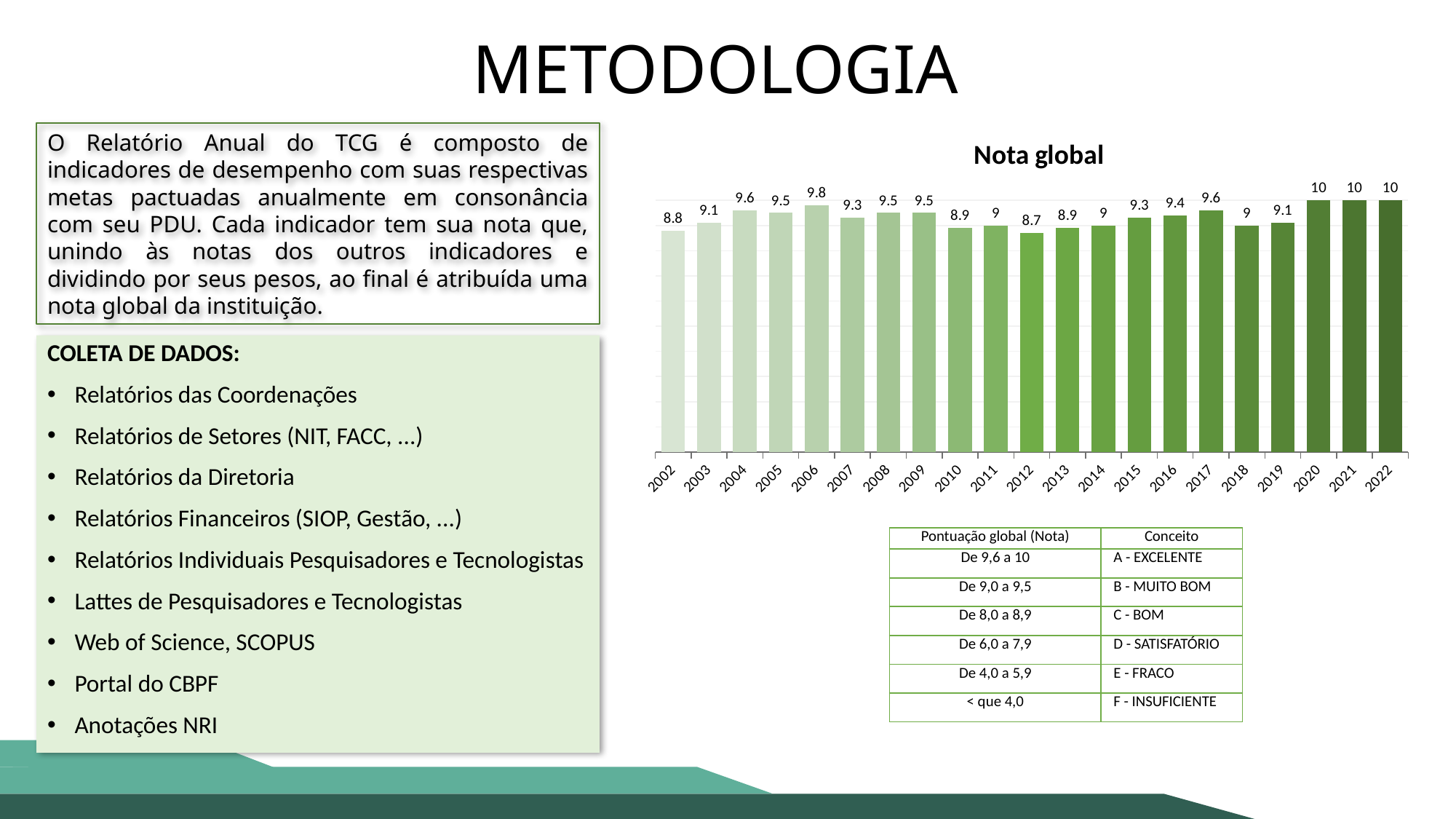
How many years are plotted in the "Nota global" chart? 21 What is the value for 2016 in the "Nota global" chart? 9.4 What is the value for 2012 in the "Nota global" chart? 8.7 What is the value for 2002 in the "Nota global" chart? 8.8 In the "Nota global" chart, which is larger, the value for 2004 or the value for 2007? 2004 What is the difference between the values for 2006 and 2012 in the "Nota global" chart? 1.1 Which year has the lowest value in the "Nota global" chart? 2012 What type of chart is shown under the title "Nota global"? bar chart What is the highest value shown in the "Nota global" chart? 10 In the "Nota global" chart, do the values rise or fall from 2019 to 2020? rise What is the value for 2006 in the "Nota global" chart? 9.8 What is the title of the chart on the slide? Nota global